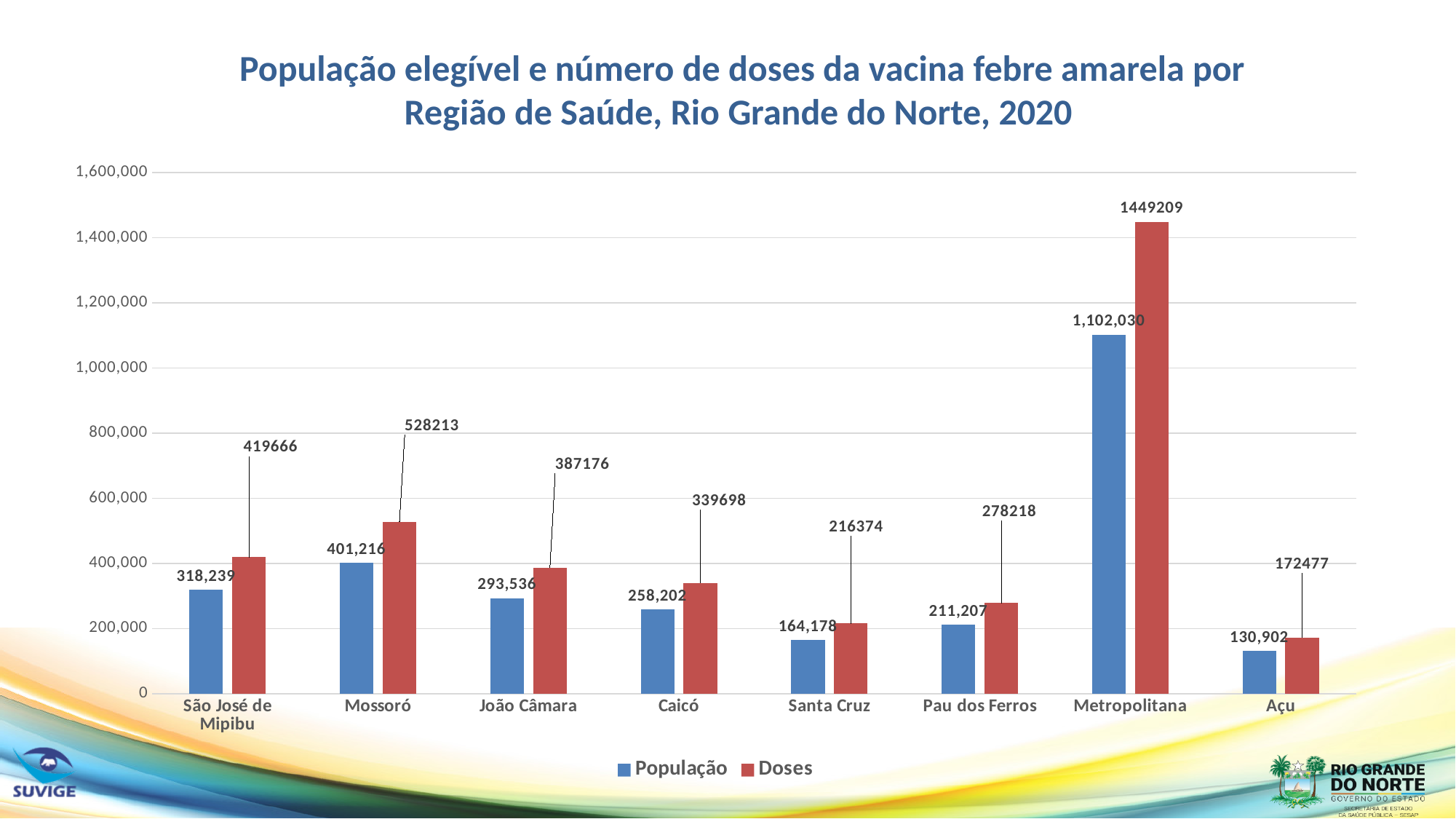
What kind of chart is shown on the slide? bar chart What is the Doses value for Metropolitana? 1449209 Which is larger for Caicó: População or Doses? Doses What is the População value for Mossoró? 401,216 Which region has the highest Doses value? Metropolitana What is the difference between Doses and População for Metropolitana? 347,179 Is the Doses value for Mossoró greater or less than 600,000? less What is the Doses value for Santa Cruz? 216374 What is the População value for Açu? 130,902 How many regions are shown on the x axis? 8 Which region has the lowest População value? Açu How many series does the legend list? 2